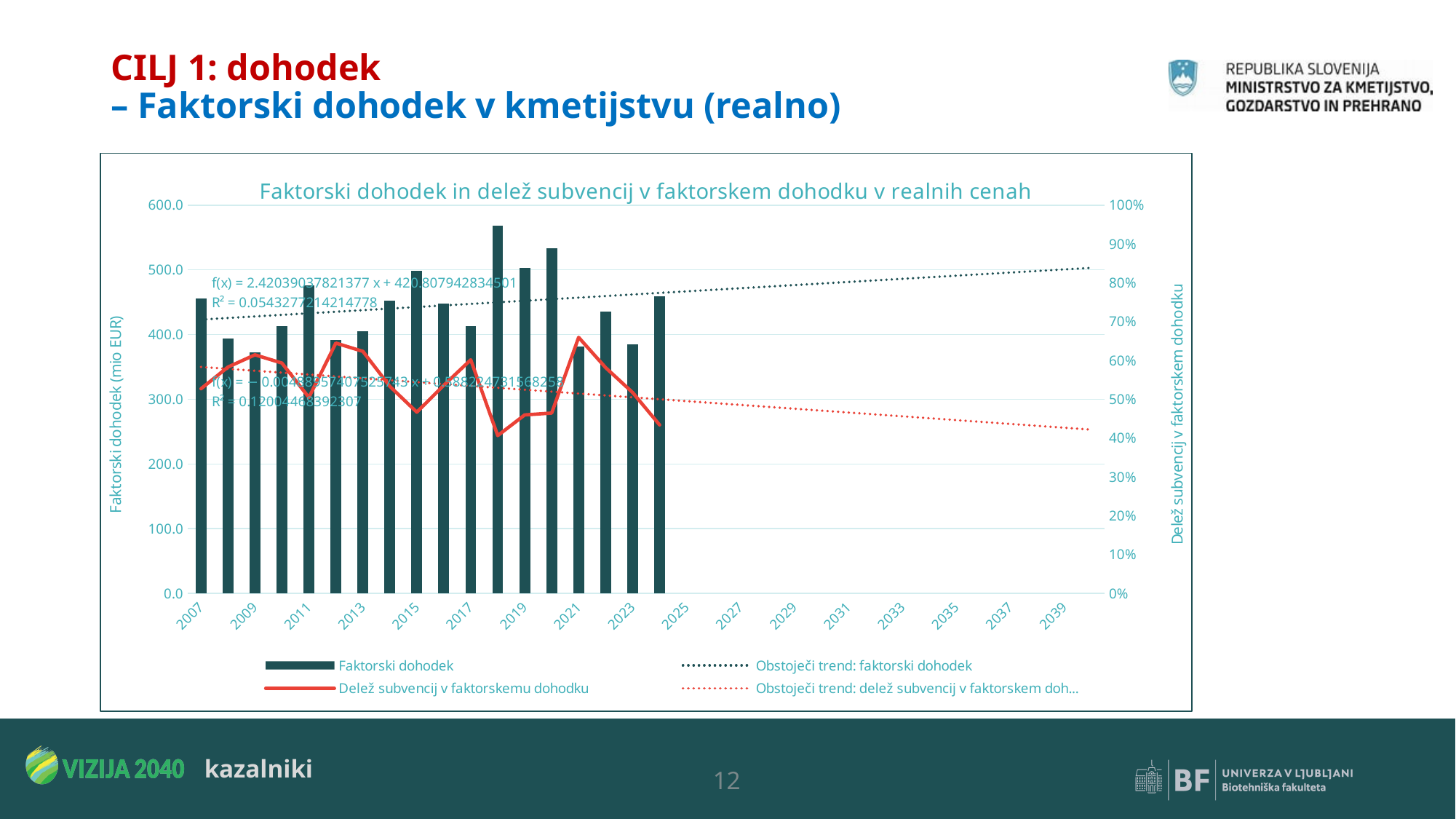
Is the Faktorski dohodek value for 2018 greater or less than 500.0? greater In which year is the Faktorski dohodek bar the highest? 2018 How many series does the chart legend list? 4 How many bars (years) are plotted for Faktorski dohodek? 18 Which year has the higher Faktorski dohodek bar, 2011 or 2013? 2011 Is the Delež subvencij v faktorskemu dohodku value for 2018 greater or less than 50%? less Does the dotted trend line 'Obstoječi trend: faktorski dohodek' rise or fall from 2007 to 2039? rise What kind of chart is shown on the slide? A combined bar and line chart Does the dotted trend line for the share of subsidies (Obstoječi trend: delež subvencij) rise or fall over the x axis? fall Is the Delež subvencij v faktorskemu dohodku value for 2021 greater or less than 60%? greater What is the title of the chart? Faktorski dohodek in delež subvencij v faktorskem dohodku v realnih cenah